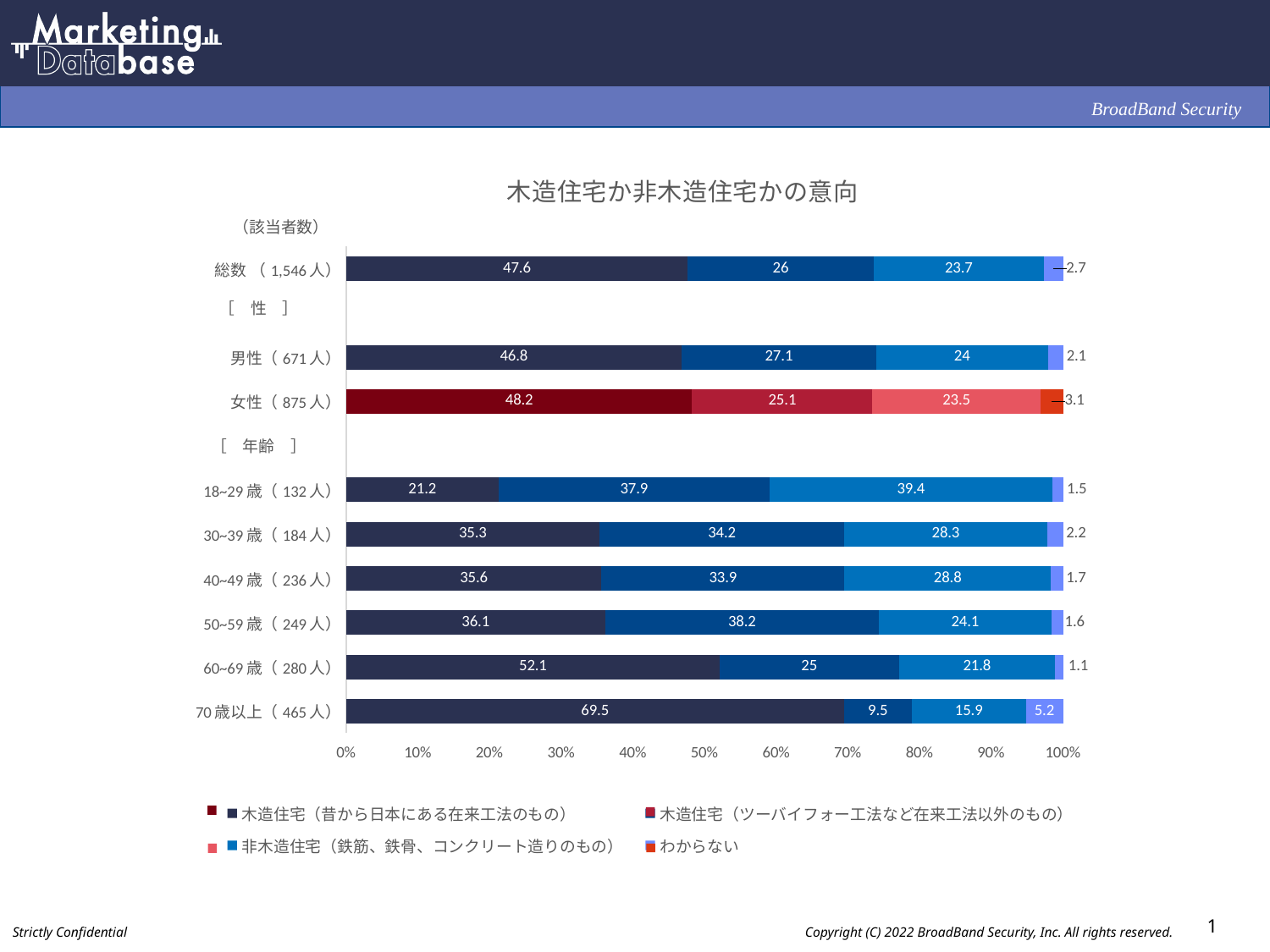
How many series does the legend list? 4 What is the difference between the 木造住宅（昔から日本にある在来工法のもの） values for 女性 (875人) and 男性 (671人)? 1.4 What is the title of the chart? 木造住宅か非木造住宅かの意向 Which category has the lowest value for 木造住宅（昔から日本にある在来工法のもの）? 18~29歳 (132人) How many categories (bars) are plotted in the chart? 9 What is the value of 非木造住宅（鉄筋、鉄骨、コンクリート造りのもの） for 18~29歳 (132人)? 39.4 What type of chart is shown on the slide? Stacked bar chart Which is larger: the 木造住宅（ツーバイフォー工法など在来工法以外のもの） value for 50~59歳 (249人) or for 60~69歳 (280人)? 50~59歳 (249人) What is the value of 木造住宅（ツーバイフォー工法など在来工法以外のもの） for 70歳以上 (465人)? 9.5 Which category has the highest value for 木造住宅（昔から日本にある在来工法のもの）? 70歳以上 (465人) What is the value of 木造住宅（昔から日本にある在来工法のもの） for 総数 (1,546人)? 47.6 What is the value of わからない for 70歳以上 (465人)? 5.2